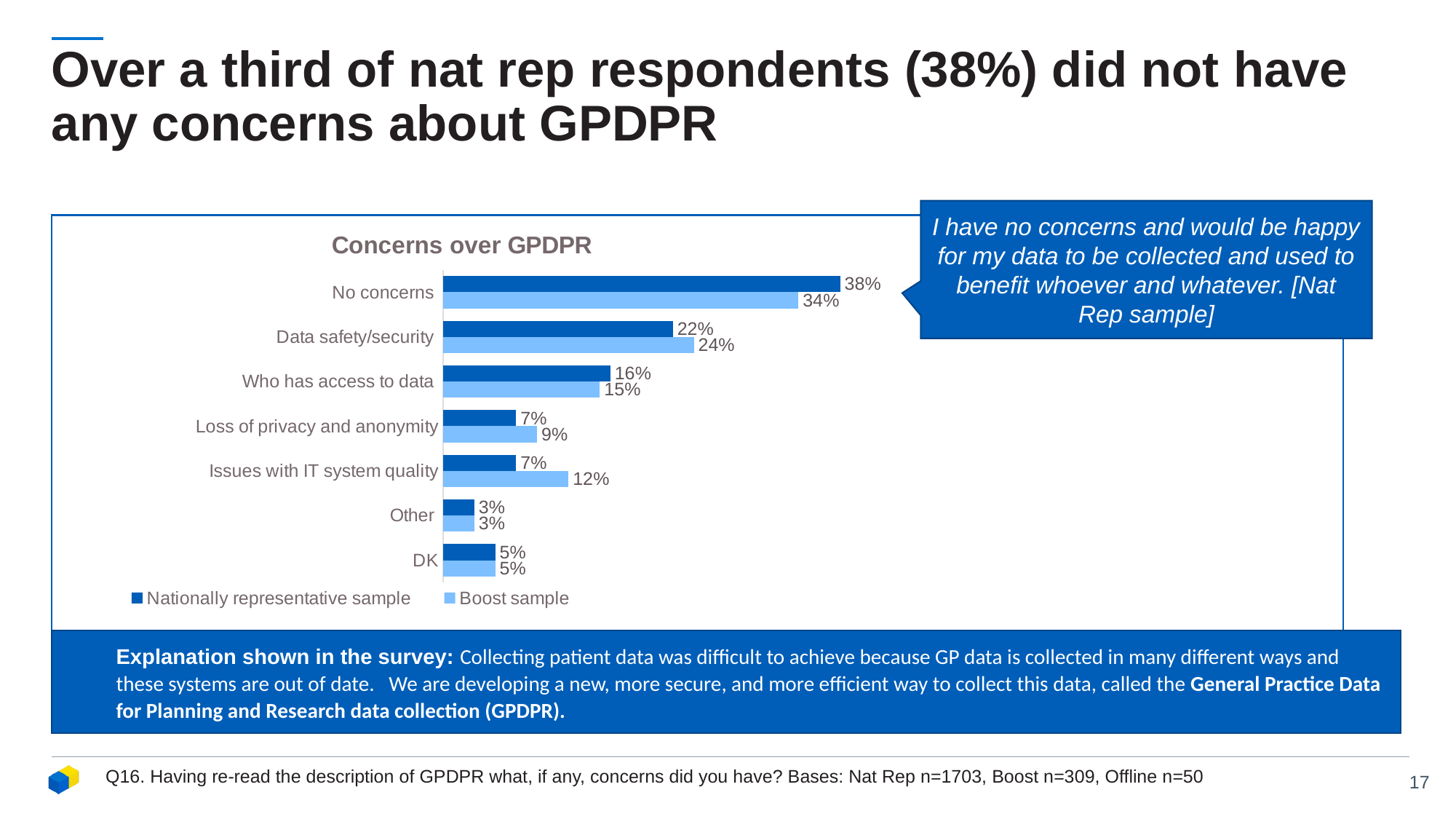
How many concern categories are shown in the chart? 7 Which category has the lowest value for the Boost sample? Other For Issues with IT system quality, which sample has the larger value? Boost sample What type of chart is shown on the slide? Bar chart What percentage of the Nationally representative sample reported No concerns? 38% How many series does the legend list? 2 Which category has the highest value for the Nationally representative sample? No concerns What is the Boost sample value for Issues with IT system quality? 12% What percentage of the Boost sample cited Data safety/security as a concern? 24% What is the title of the chart? Concerns over GPDPR What is the difference between the Boost sample and Nationally representative sample values for Issues with IT system quality? 5 percentage points What is the difference between the Nationally representative sample and Boost sample values for No concerns? 4 percentage points